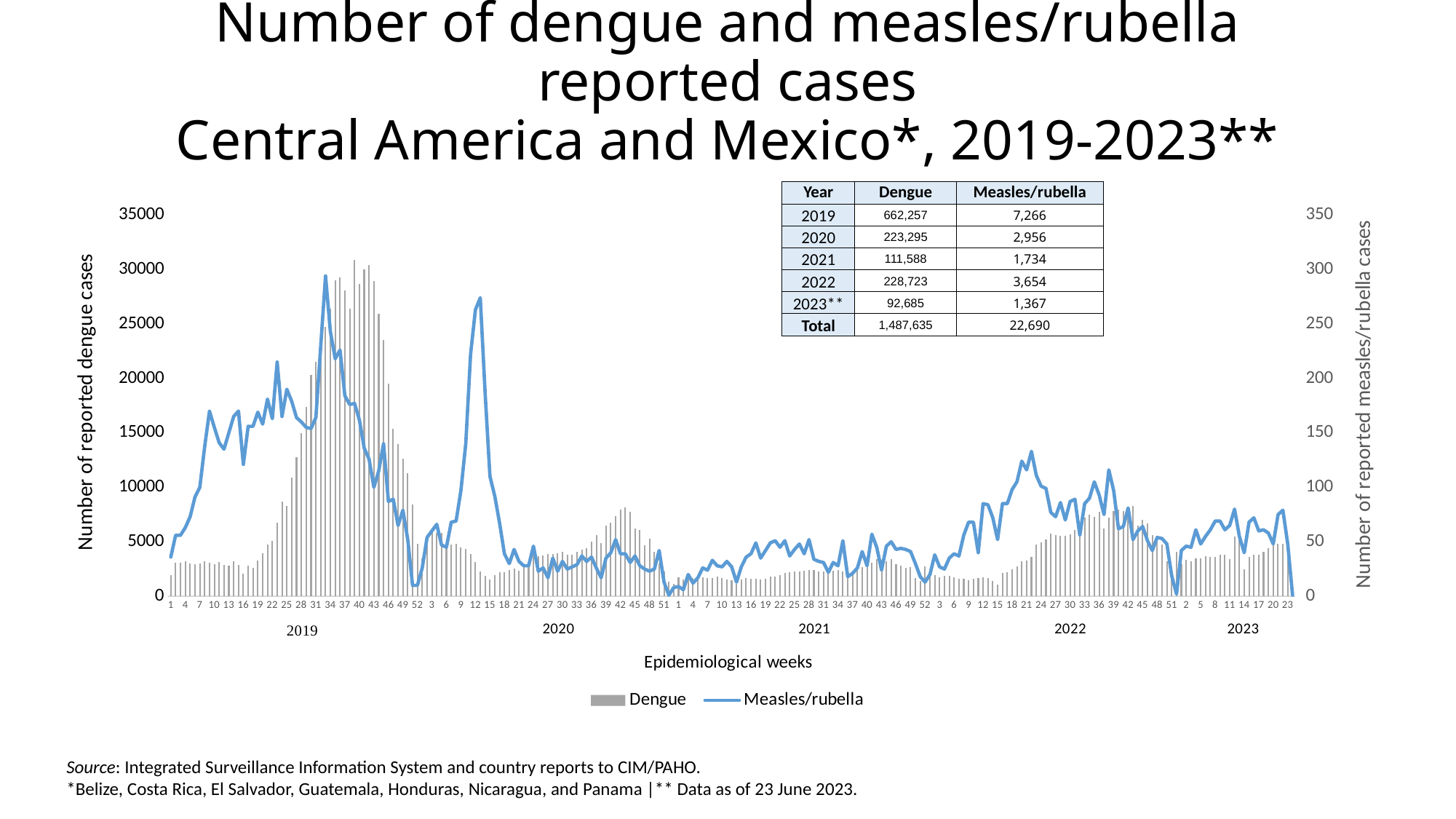
According to the table, what is the difference between dengue cases in 2020 and 2021? 111,707 According to the table on the chart, how many dengue cases were reported in 2019? 662,257 According to the table, which year had more dengue cases, 2020 or 2022? 2022 What kind of chart is shown on the slide? Combined bar and line chart According to the table on the chart, how many measles/rubella cases were reported in 2022? 3,654 How many series does the chart legend list? 2 What is the title of the chart? Number of dengue and measles/rubella reported cases Central America and Mexico*, 2019-2023** According to the table, what is the total number of dengue cases for 2019-2023? 1,487,635 According to the table, which year had the lowest number of measles/rubella cases? 2023 What is the x-axis label of the chart? Epidemiological weeks According to the table, which year had the highest number of dengue cases? 2019 Is the peak weekly value of the Measles/rubella line in 2022 greater or less than 100? greater